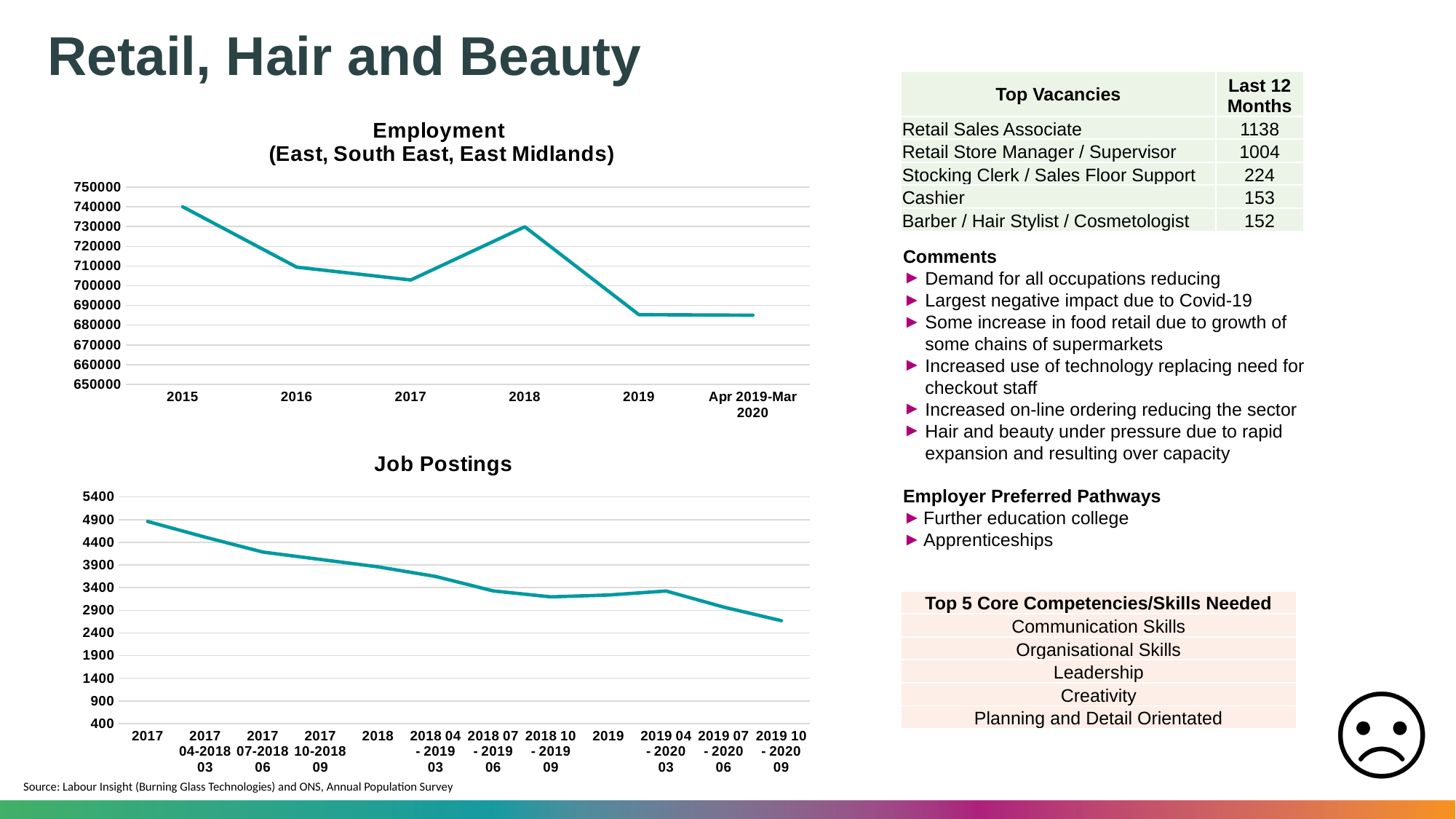
In the Employment chart, is the value for 2019 greater or less than 690000? less In the Employment chart, how many time periods are plotted along the x axis? 6 In the Employment chart, which is higher, employment in 2016 or in 2018? 2018 In the Employment chart, which period has the highest employment? 2015 In the Employment chart, is the value for 2018 greater or less than 720000? greater In the Job Postings chart, which period has the lowest number of job postings? 2019 10 - 2020 09 In the Job Postings chart, do the values generally rise or fall from left to right? fall In the Job Postings chart, is the value for 2017 greater or less than 4400? greater What kind of chart is the Job Postings chart? line chart In the Job Postings chart, which period has the highest number of job postings? 2017 What kind of chart is the Employment (East, South East, East Midlands) chart? line chart In the Job Postings chart, how many time periods are plotted along the x axis? 12